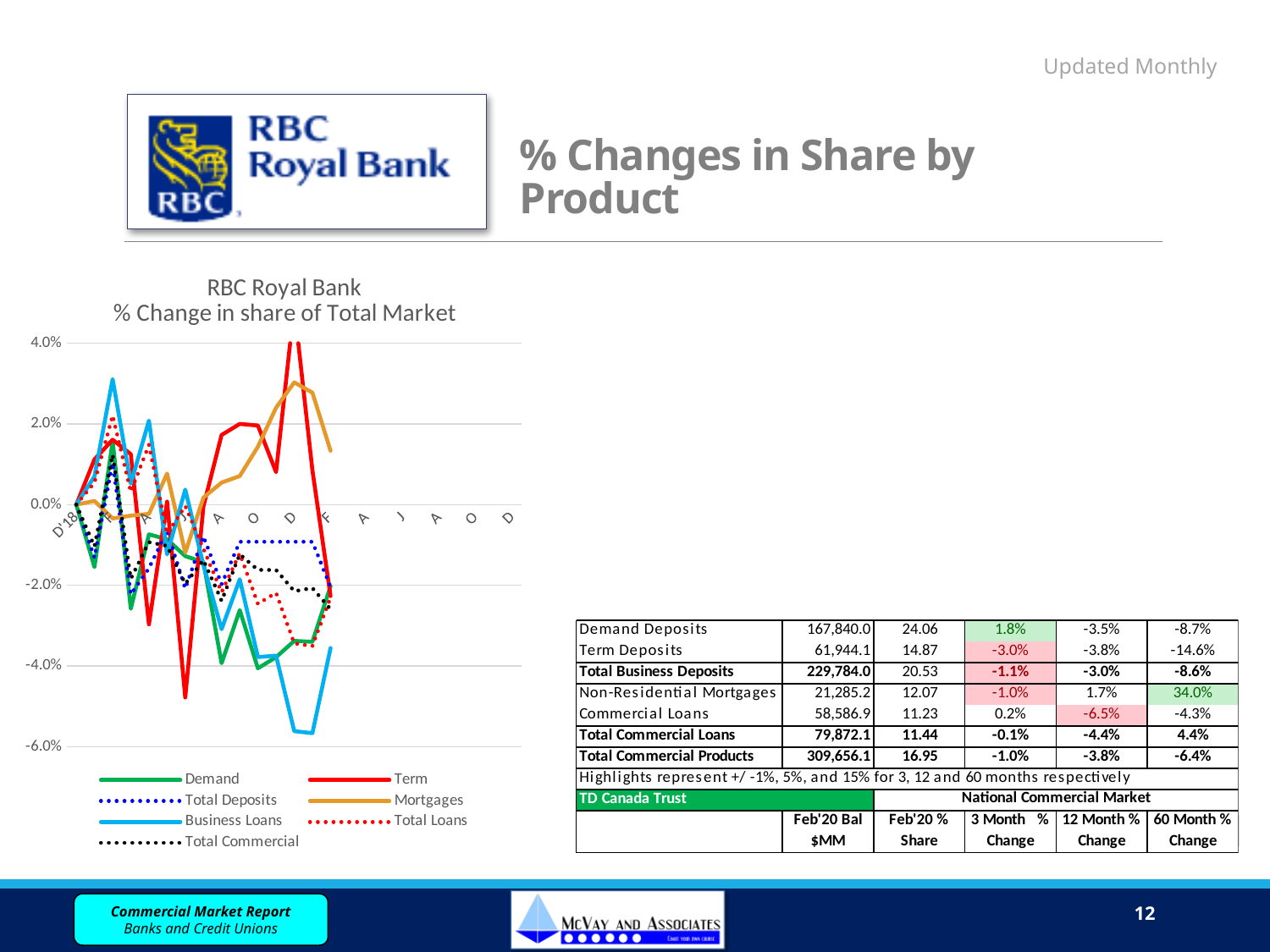
Is the lowest value of the Business Loans line greater or less than -4.0%? less Is the final value of the Term line (at F) greater or less than 0.0%? less Which colour is used for the Term series in the chart? red Is the highest value of the Mortgages line greater or less than 2.0%? greater Does the Mortgages line end higher or lower than where it starts at D'18? higher What is the title of the chart? RBC Royal Bank % Change in share of Total Market Which series reaches the highest point on the chart, Term or Demand? Term How many series does the chart legend list? 7 What kind of chart is shown on the slide? line chart